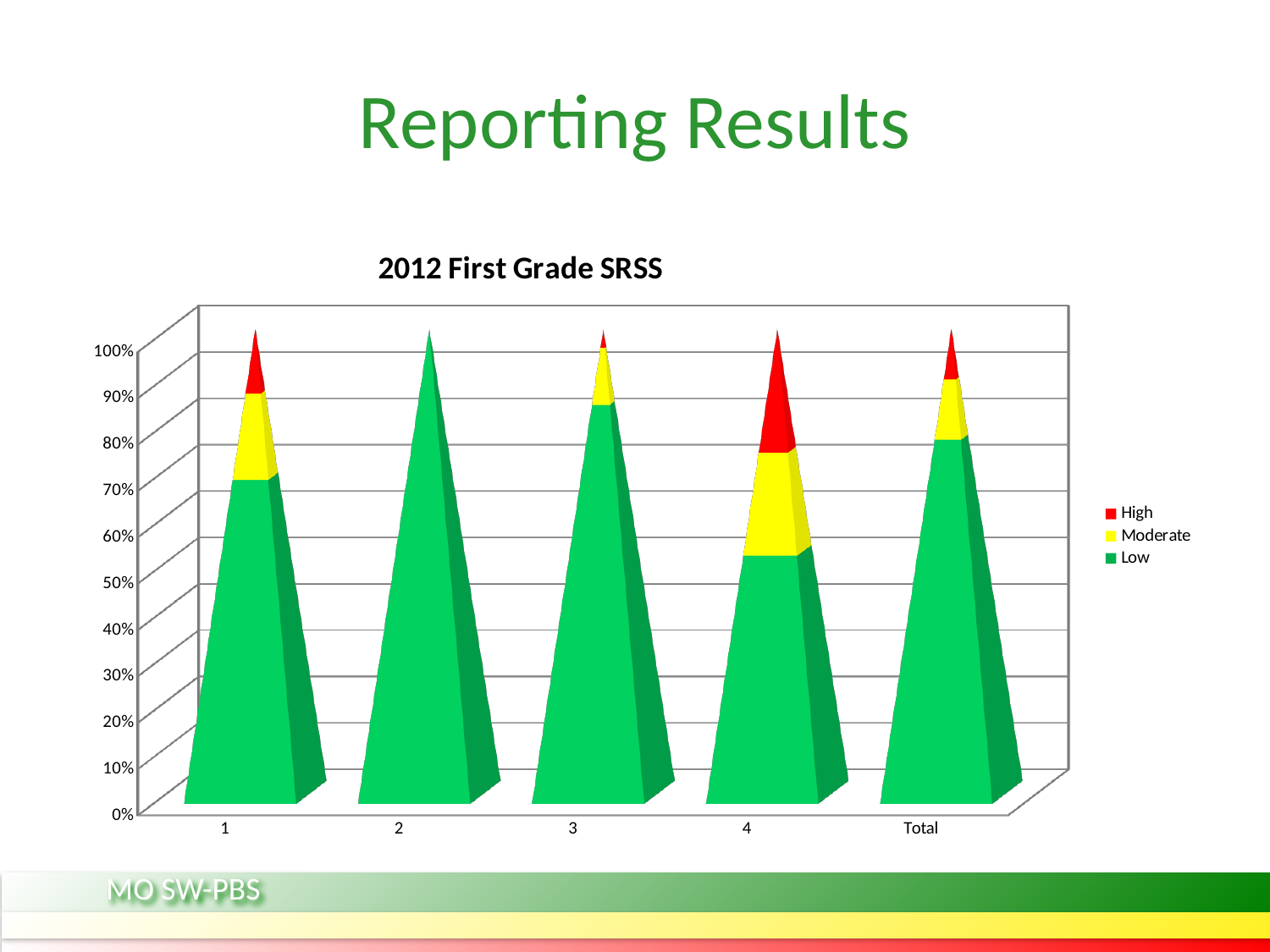
What is the title of the chart on the slide? 2012 First Grade SRSS Which colour represents the High series in the chart? Red How many series does the chart's legend list? 3 What kind of chart is shown on the slide? Stacked bar chart Is the Low value for category 4 greater or less than 70%? less Which category has the smallest Low share in the chart? 4 Which has the larger High share, category 3 or category 4? 4 Is the Low value for category 1 greater or less than 50%? greater Is the Low value for category 2 greater or less than 90%? greater Which category has the largest High share in the chart? 4 Which category has the largest Low share in the chart? 2 How many categories are shown along the x axis of the chart? 5